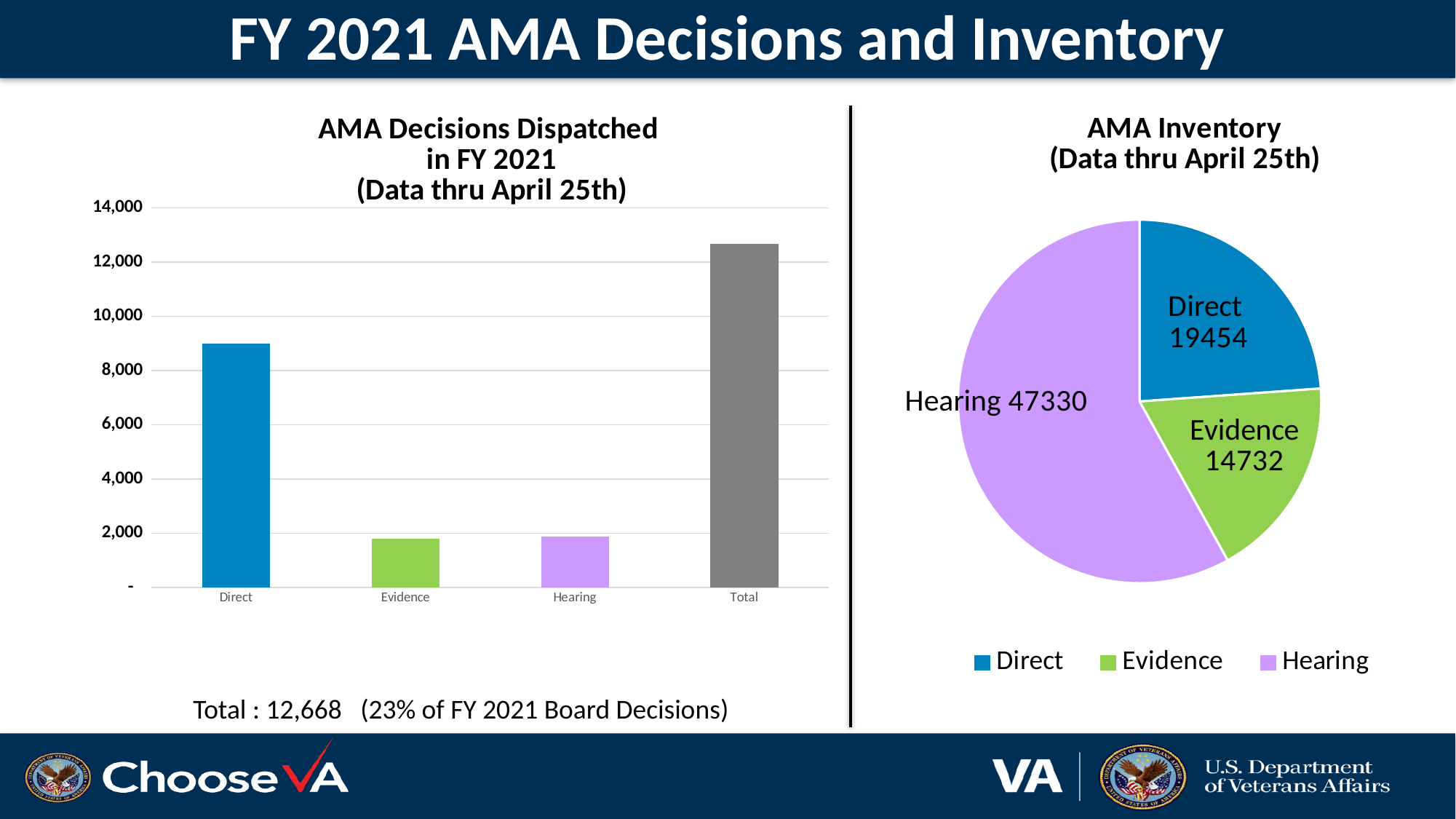
In the AMA Decisions Dispatched chart, is the value for Evidence greater or less than 2,000? less What kind of chart is the AMA Decisions Dispatched chart on the left? Bar chart In the AMA Decisions Dispatched chart, which is larger, Direct or Evidence? Direct In the AMA Inventory pie chart, which category has the largest slice? Hearing In the AMA Inventory pie chart, which category has the smallest slice? Evidence In the AMA Inventory pie chart, what is the value for Evidence? 14732 In the AMA Inventory pie chart, what is the value for Hearing? 47330 In the AMA Decisions Dispatched chart, which category has the tallest bar? Total In the AMA Inventory pie chart, what is the value for Direct? 19454 In the AMA Inventory pie chart, how many categories does the legend list? 3 In the AMA Decisions Dispatched chart, is the value for Direct greater or less than 8,000? greater In the AMA Inventory pie chart, what is the difference between the Hearing and Direct values? 27876